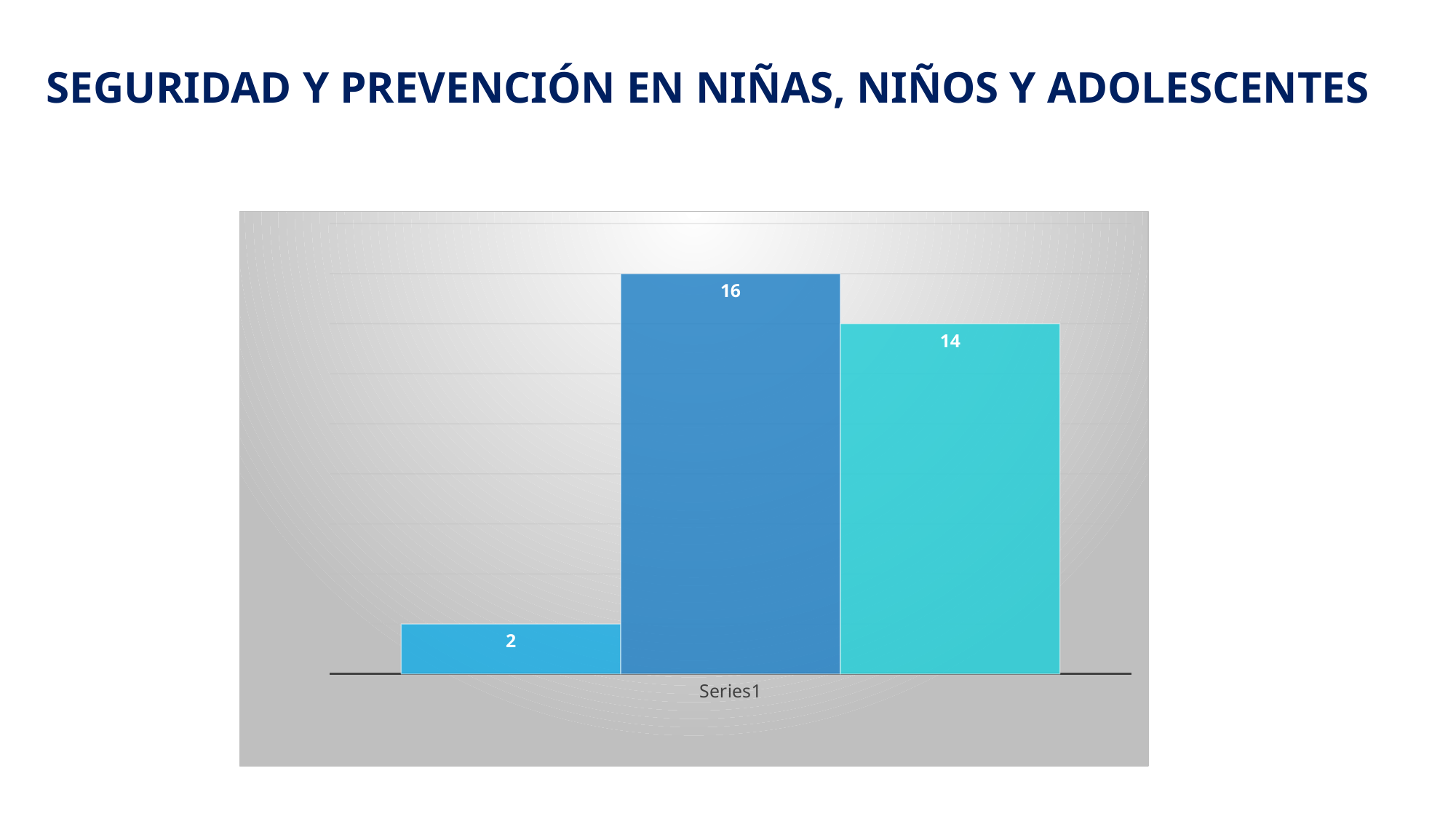
Which bar has the highest value: the left, middle or right bar? middle Which is larger, the value of the middle bar or the value of the rightmost bar? middle bar What label appears on the horizontal axis of the chart? Series1 What is the value shown on the leftmost bar? 2 What kind of chart is shown on the slide? bar chart How many bars are plotted in the chart? 3 What is the value shown on the rightmost bar? 14 Which bar has the lowest value: the left, middle or right bar? left What is the difference between the middle bar's value and the leftmost bar's value? 14 What is the title of the slide? SEGURIDAD Y PREVENCIÓN EN NIÑAS, NIÑOS Y ADOLESCENTES What is the difference between the middle bar's value and the rightmost bar's value? 2 What is the value shown on the middle bar? 16